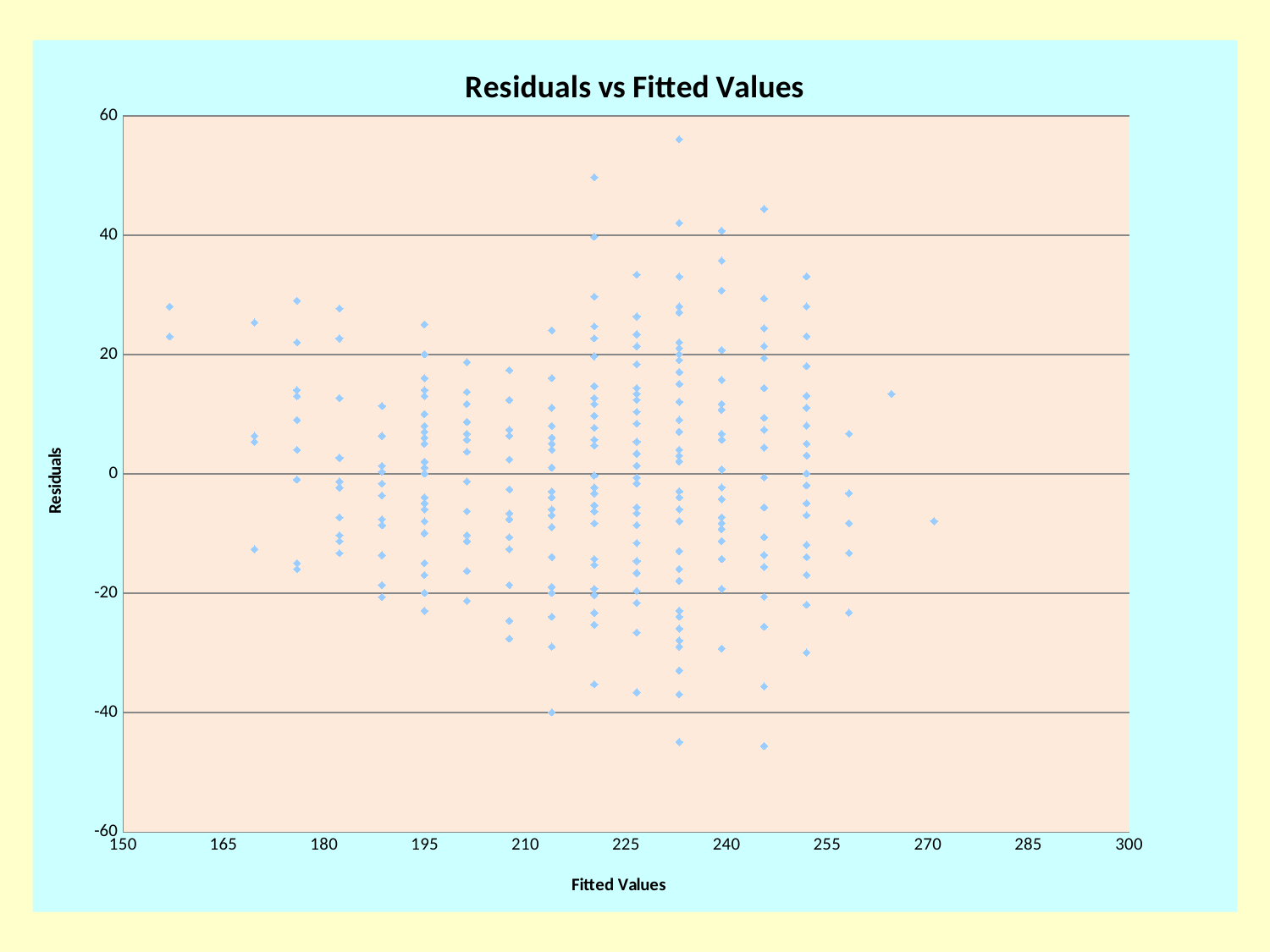
Is the lowest residual plotted on the chart greater or less than -60? greater Is the lowest residual plotted on the chart greater or less than -40? less Is the highest residual plotted on the chart greater or less than 60? less What is the label on the vertical axis of the chart? Residuals What kind of chart is shown on the slide? Scatter plot What is the title of the chart? Residuals vs Fitted Values